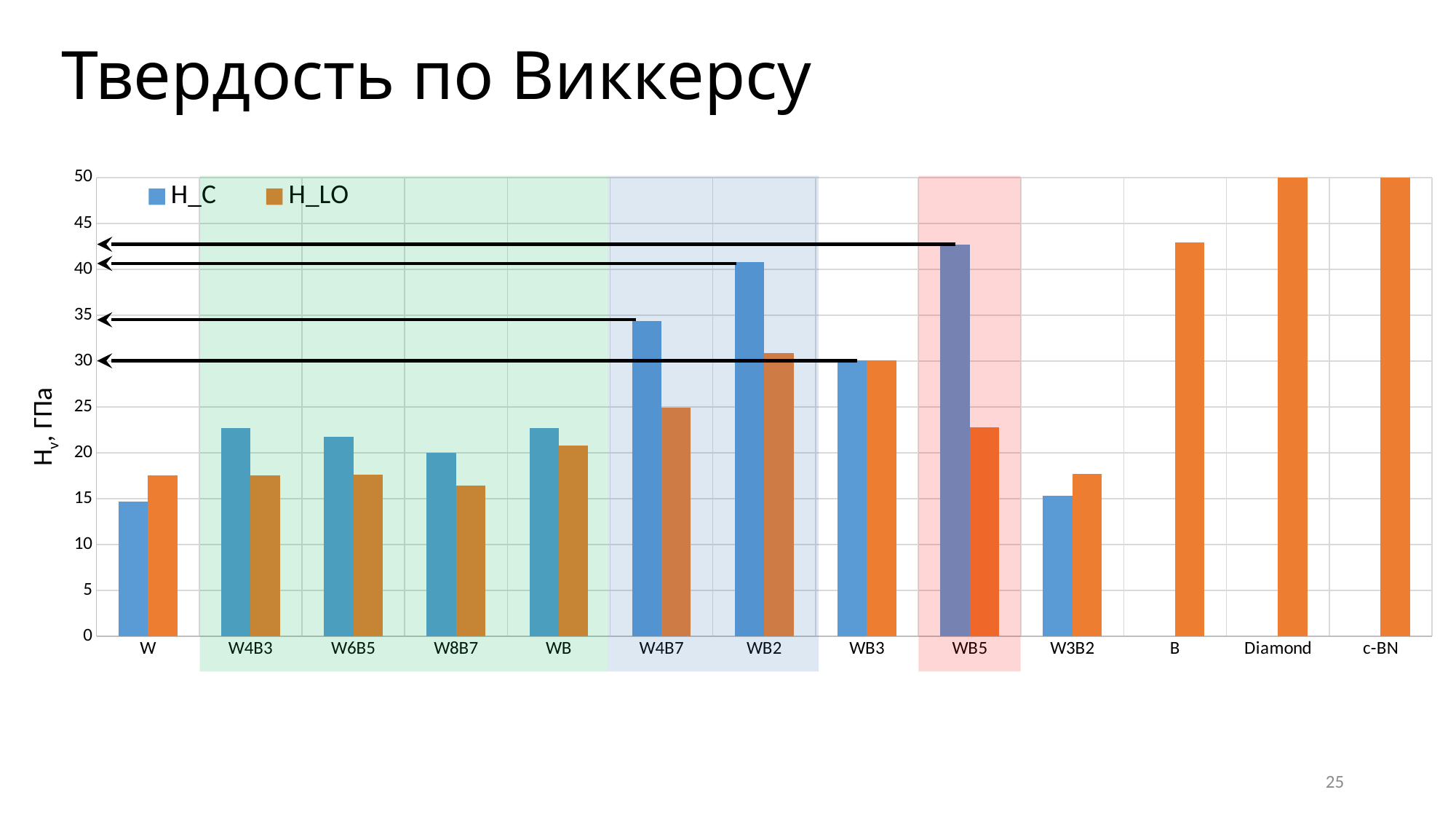
What kind of chart is shown on the slide? bar chart For W4B7, which is larger, H_C or H_LO? H_C Which category has the highest H_C value? WB5 For W, which is larger, H_C or H_LO? H_LO Is the H_LO value for B greater or less than 40? greater How many categories are shown on the x axis? 13 How many series does the legend list? 2 Is the H_C value for W greater or less than 20? less What are the names of the two series in the legend? H_C and H_LO What is the title of the slide? Твердость по Виккерсу Is the H_C value for W4B7 greater or less than 30? greater